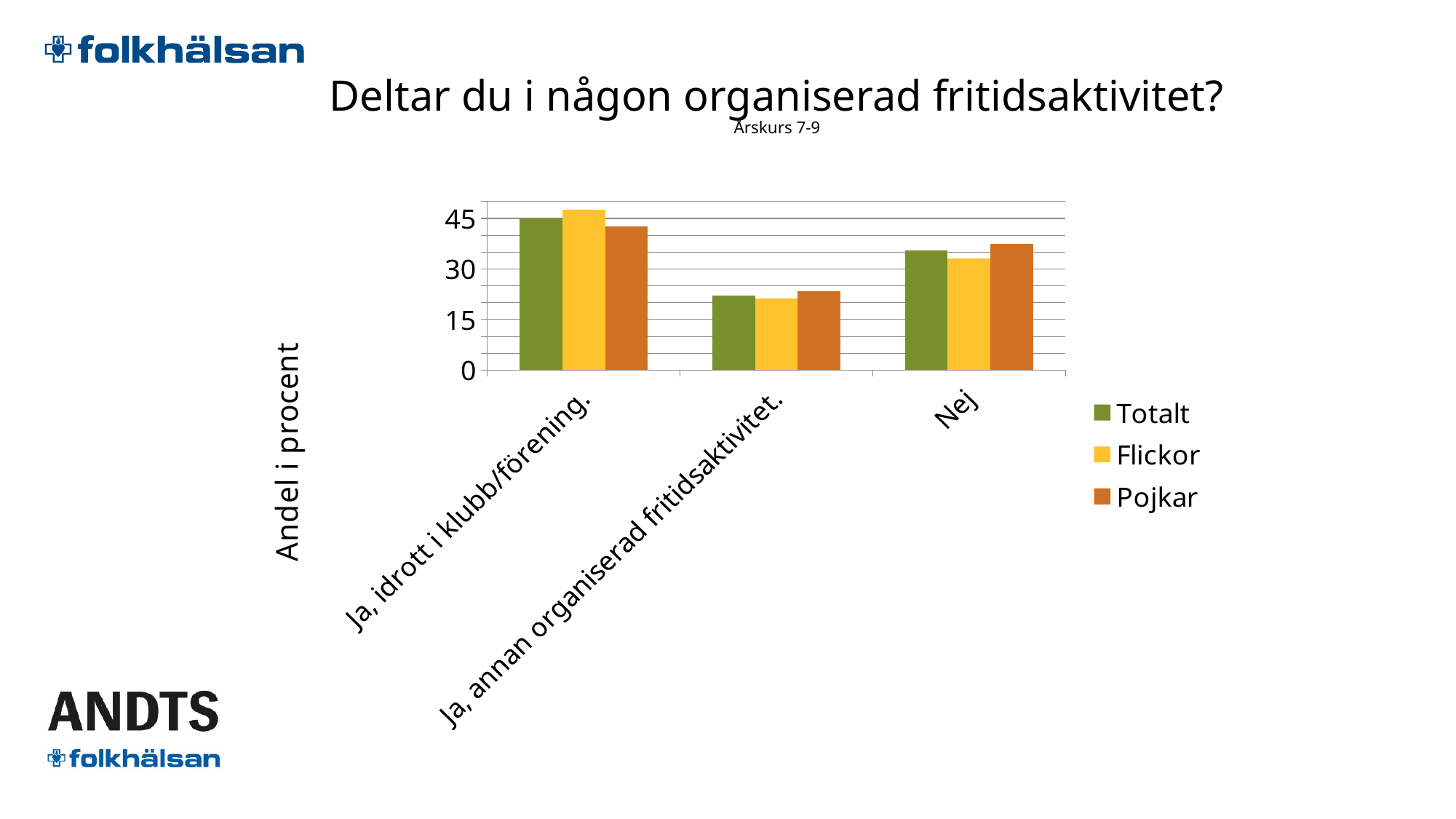
Which category has the highest value for Flickor? Ja, idrott i klubb/förening. For "Nej", which is larger: Pojkar or Flickor? Pojkar Which category has the lowest value for Pojkar? Ja, annan organiserad fritidsaktivitet. What kind of chart is shown on the slide? bar chart How many series does the legend list? 3 Is the value for Pojkar in "Nej" greater or less than 30? greater Is the value for Totalt in "Ja, annan organiserad fritidsaktivitet." greater or less than 30? less Is the value for Pojkar in "Ja, idrott i klubb/förening." greater or less than 45? less How many categories are shown on the x axis? 3 What is the label on the vertical axis of the chart? Andel i procent For "Ja, idrott i klubb/förening.", which is larger: Flickor or Pojkar? Flickor